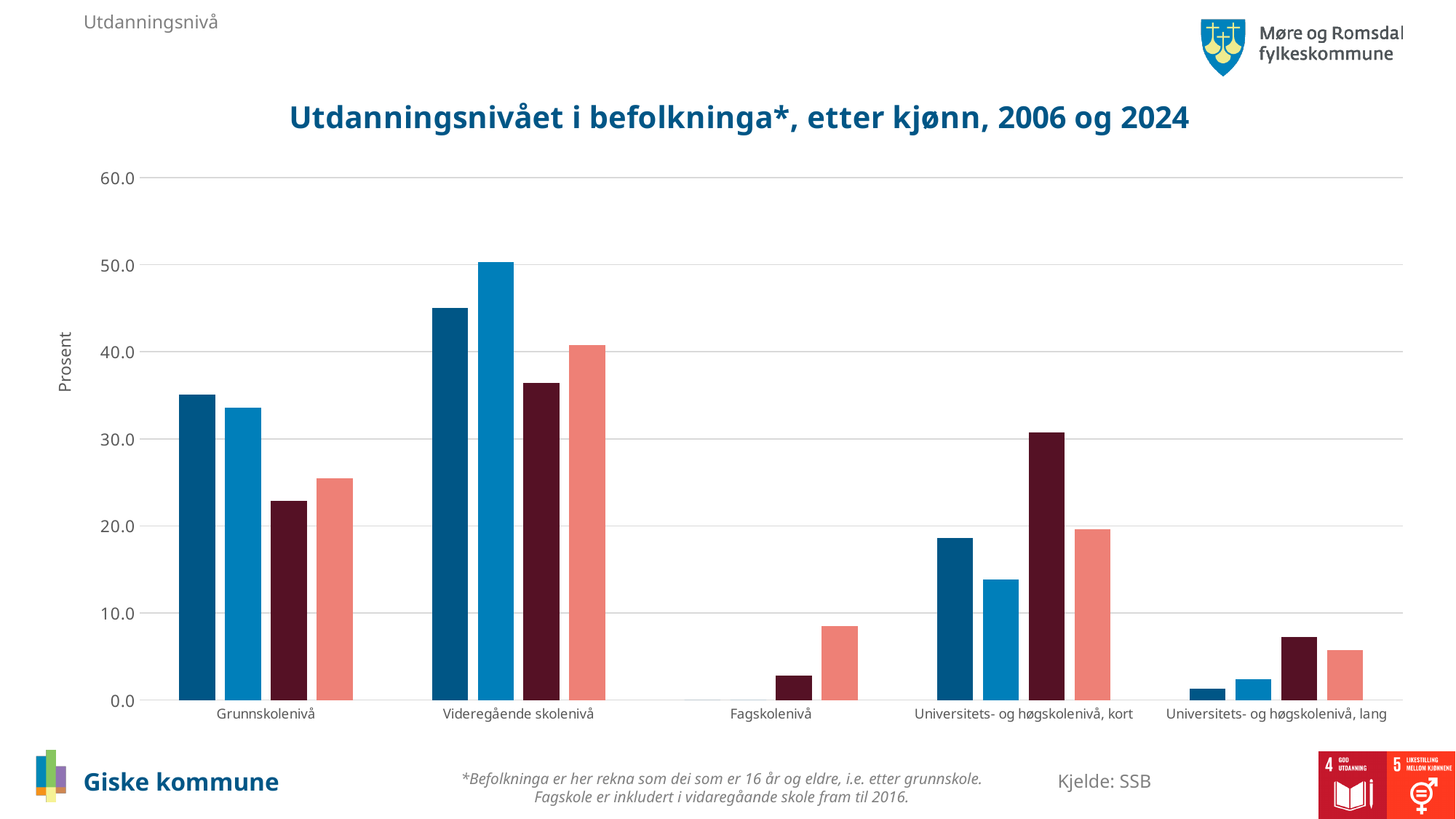
How many education-level categories are shown along the x axis? 5 Is the tallest bar for Videregående skolenivå greater or less than 40.0? greater How many bars are shown for the Fagskolenivå category? 2 What is the title of the chart? Utdanningsnivået i befolkninga*, etter kjønn, 2006 og 2024 Is the tallest bar for Fagskolenivå greater or less than 10.0? less What source is cited for the chart data? SSB Is the tallest bar for Universitets- og høgskolenivå, kort greater or less than 20.0? greater What type of chart is shown on the slide? bar chart Which category has the tallest bar in the chart? Videregående skolenivå Which category has a taller tallest bar: Grunnskolenivå or Universitets- og høgskolenivå, kort? Grunnskolenivå